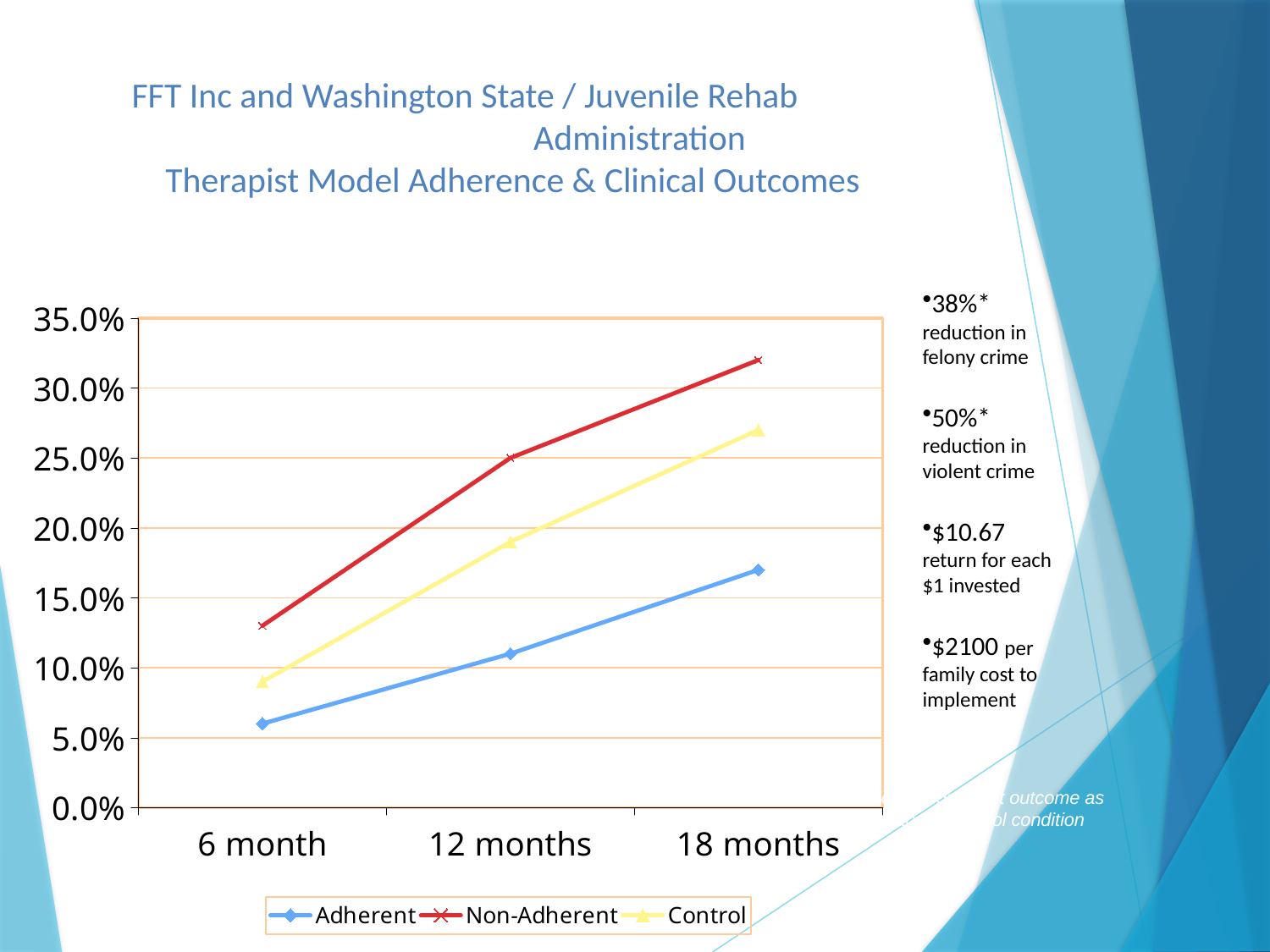
What kind of chart is shown on the slide? Line chart Is the Non-Adherent value at 18 months greater or less than 30.0%? greater How many series does the chart legend list? 3 Is the Control value at 18 months greater or less than 25.0%? greater At 12 months, which is larger: the Control value or the Adherent value? Control Which series has the highest value at 18 months? Non-Adherent Is the Adherent value at 18 months greater or less than 15.0%? greater Do the values of the Non-Adherent series rise or fall from 6 month to 18 months? rise What are the three series names listed in the chart legend? Adherent, Non-Adherent, Control Which series has the lowest value at 6 month? Adherent How many time points are shown on the x axis of the chart? 3